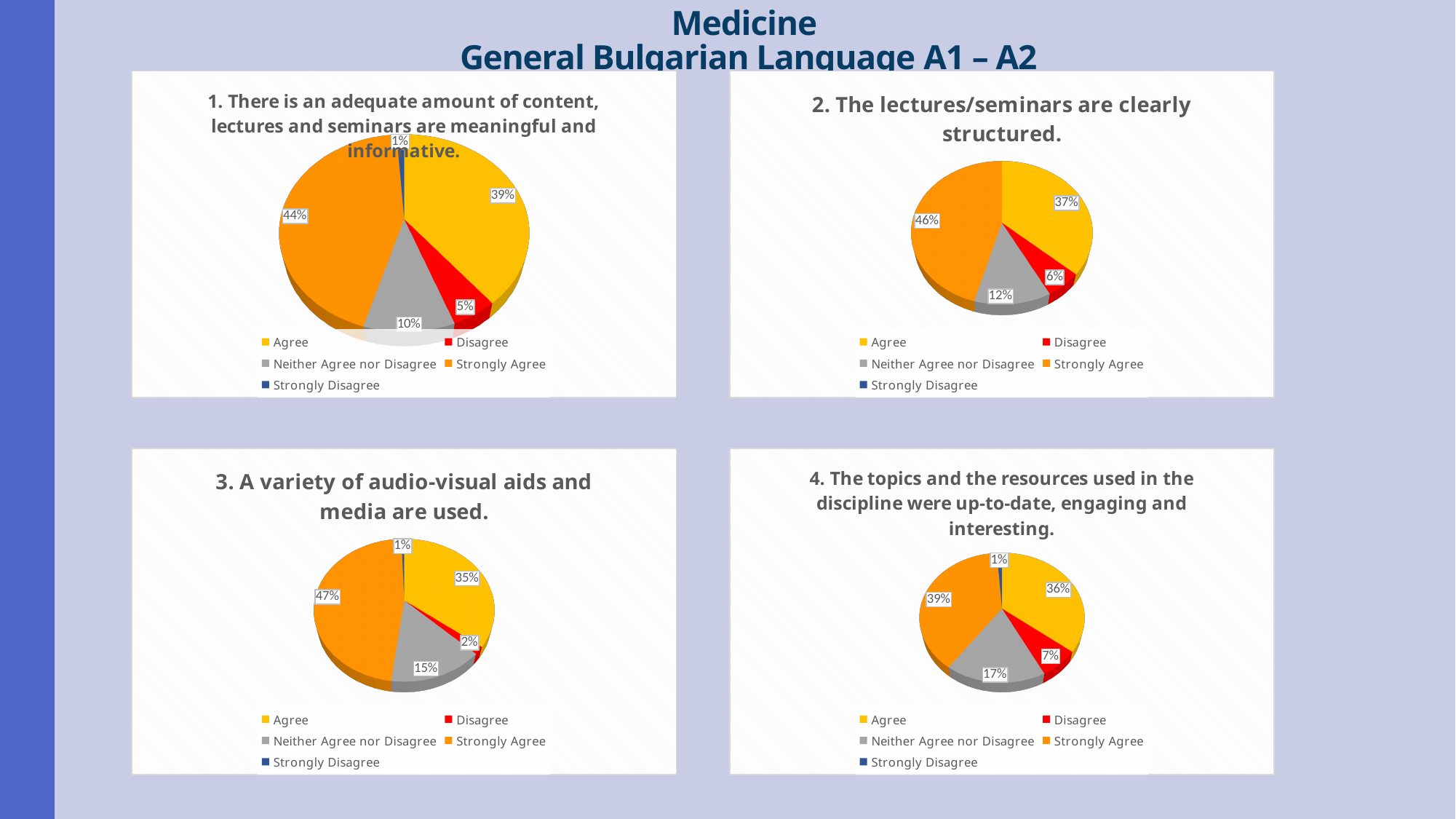
How many entries does the legend list in the chart titled '1. There is an adequate amount of content, lectures and seminars are meaningful and informative.'? 5 In the chart titled '4. The topics and the resources used in the discipline were up-to-date, engaging and interesting.', what percentage is shown for Neither Agree nor Disagree? 17% In the chart titled '3. A variety of audio-visual aids and media are used.', what percentage is shown for Strongly Agree? 47% In the chart titled '2. The lectures/seminars are clearly structured.', what percentage is shown for Neither Agree nor Disagree? 12% In the chart titled '4. The topics and the resources used in the discipline were up-to-date, engaging and interesting.', what is the difference between the Strongly Agree and Agree percentages? 3% In the chart titled '2. The lectures/seminars are clearly structured.', which category has the largest share? Strongly Agree In the chart titled '3. A variety of audio-visual aids and media are used.', which category has the smallest share? Strongly Disagree In the chart titled '2. The lectures/seminars are clearly structured.', what is the difference between the Strongly Agree and Agree percentages? 9% What type of chart is used for '4. The topics and the resources used in the discipline were up-to-date, engaging and interesting.'? Pie chart In the chart titled '1. There is an adequate amount of content, lectures and seminars are meaningful and informative.', what percentage is shown for Strongly Agree? 44% In the chart titled '3. A variety of audio-visual aids and media are used.', which is larger, Neither Agree nor Disagree or Disagree? Neither Agree nor Disagree In the chart titled '1. There is an adequate amount of content, lectures and seminars are meaningful and informative.', what percentage is shown for Disagree? 5%